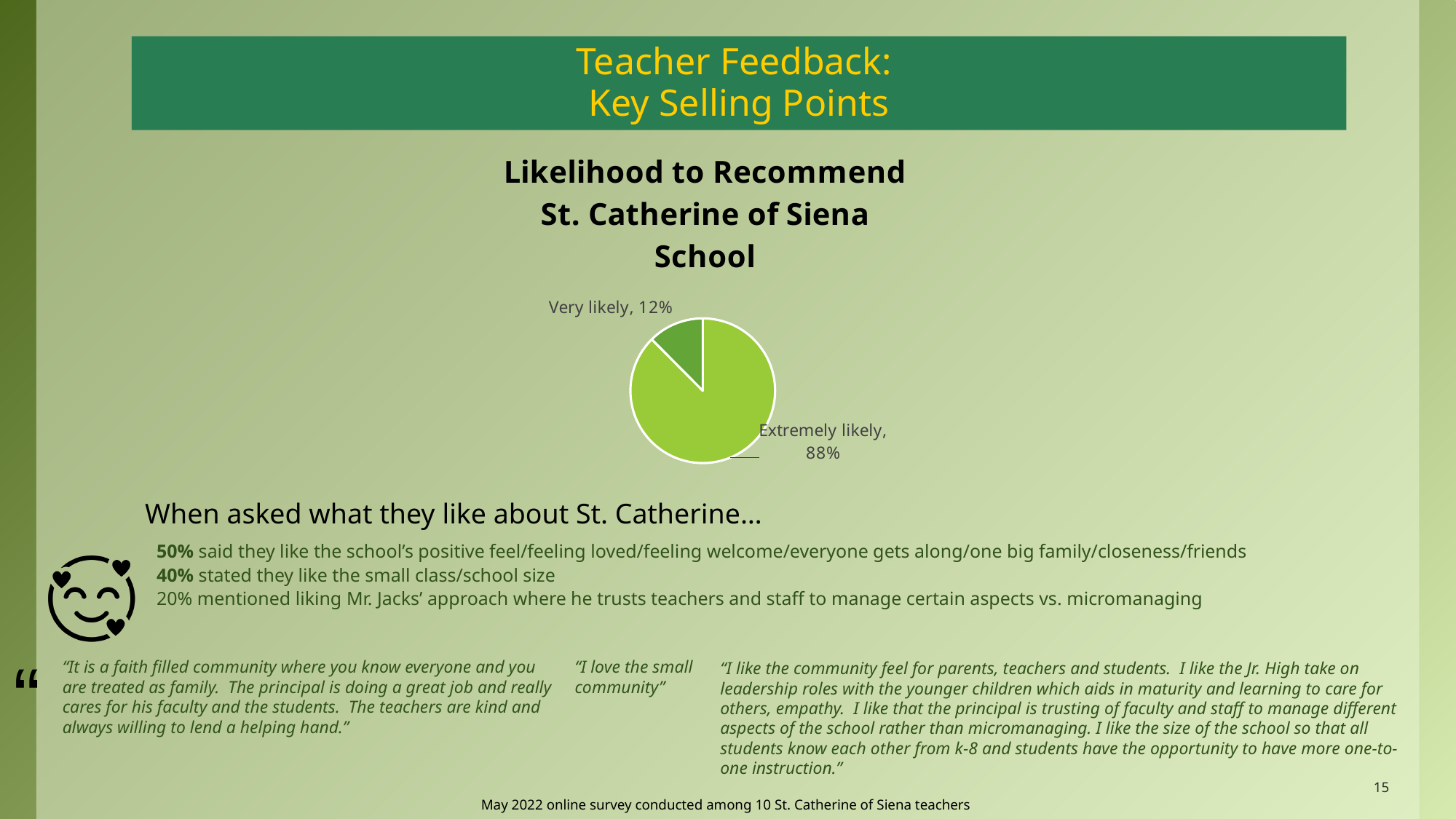
What is the title of the chart? Likelihood to Recommend St. Catherine of Siena School What percentage of teachers said they are very likely to recommend the school? 12% Which category has the smallest share of the pie? Very likely What percentage of teachers said they are extremely likely to recommend the school? 88% Which slice is larger, Extremely likely or Very likely? Extremely likely What kind of chart is shown on the slide? pie chart What is the combined total of the two slices shown in the pie chart? 100% Which category has the largest share of the pie? Extremely likely What share of the pie does the Very likely slice represent? 12% What is the difference in percentage points between the Extremely likely and Very likely slices? 76 How many slices does the pie chart have? 2